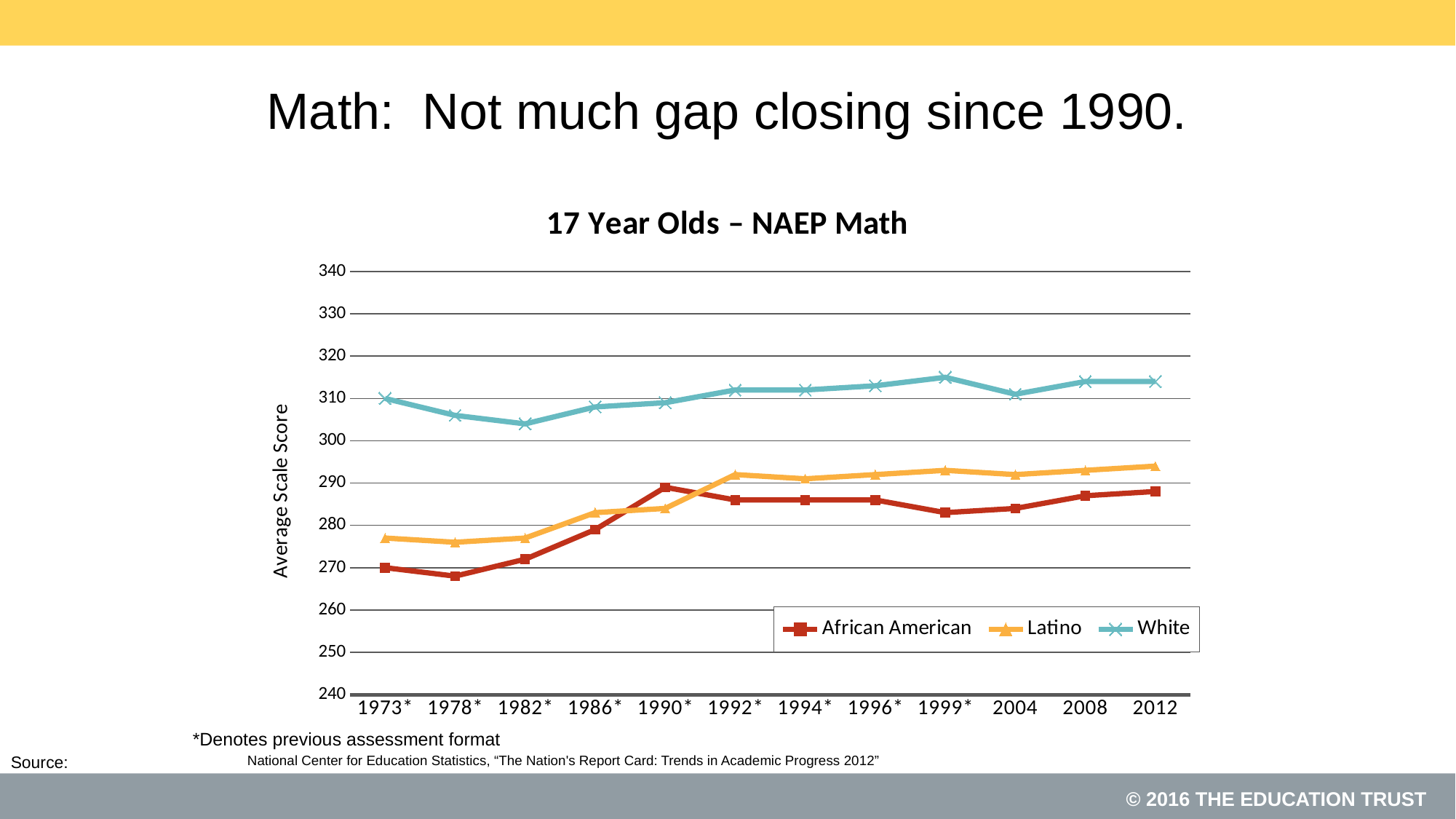
Is the White score in 1982* greater or less than 310? less In 1990*, which was larger, the African American score or the Latino score? African American Which group had the lowest average scale score in 1973*? African American Is the African American score in 1990* greater or less than 280? greater What type of chart is shown on the slide? line chart How many assessment years are plotted along the x axis? 12 Is the Latino score in 2012 greater or less than 300? less How many series does the legend list? 3 What is the y-axis label of the chart? Average Scale Score What is the title of the chart? 17 Year Olds – NAEP Math Did the White score rise or fall from 1973* to 1982*? fall Which group had the highest average scale score in 2012? White